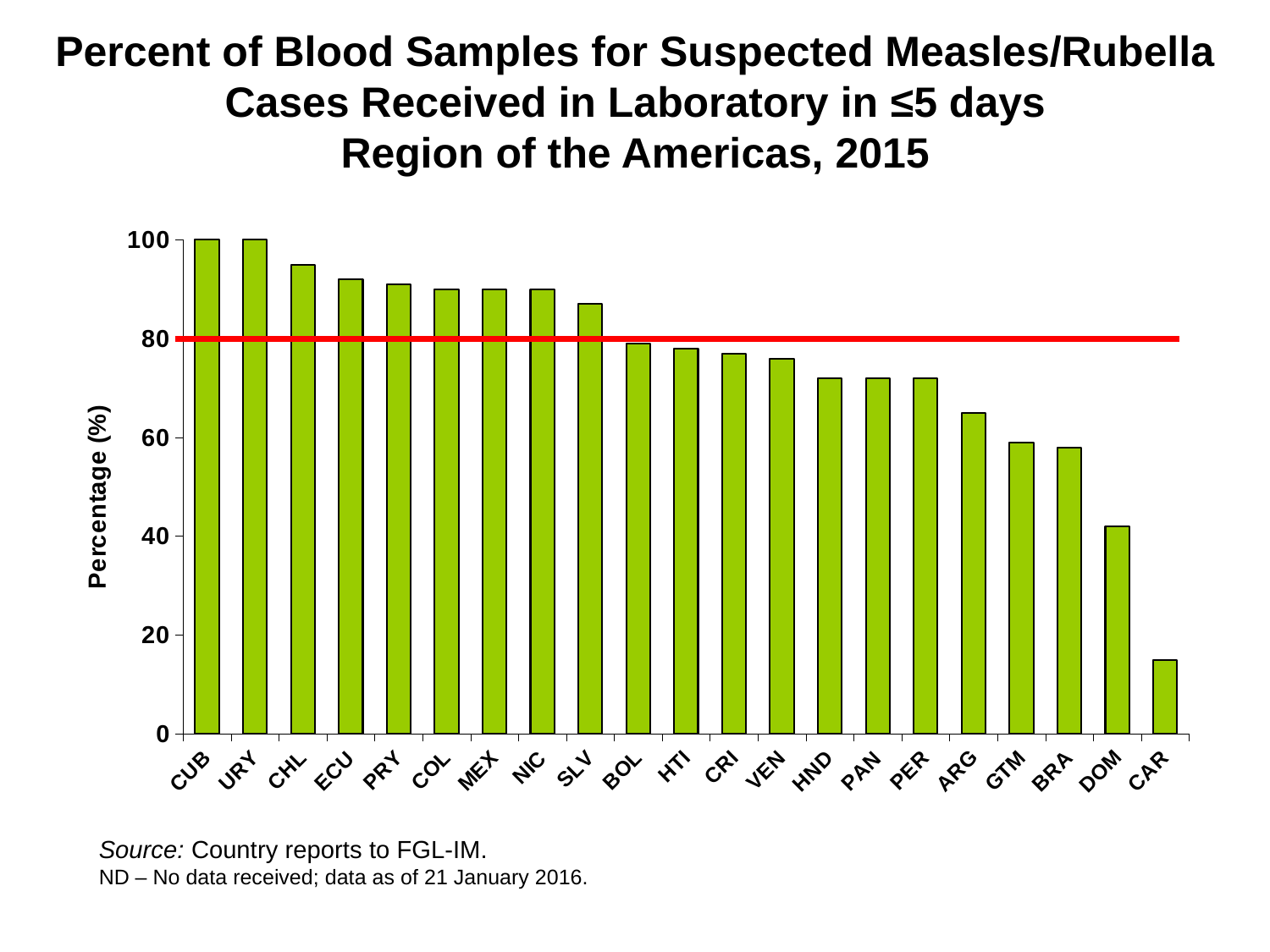
What is the percentage value for URY? 100 Is the value for CHL greater or less than 80? greater Is the value for CAR greater or less than 20? less What kind of chart is shown on the slide? bar chart At what percentage is the horizontal red reference line drawn? 80 Which country has the lowest percentage in the chart? CAR What is the percentage value for CUB? 100 Which has a higher percentage, ARG or DOM? ARG Do the values rise or fall moving from left to right along the x axis? fall How many countries are shown on the x axis of the chart? 21 Is the value for DOM greater or less than 60? less